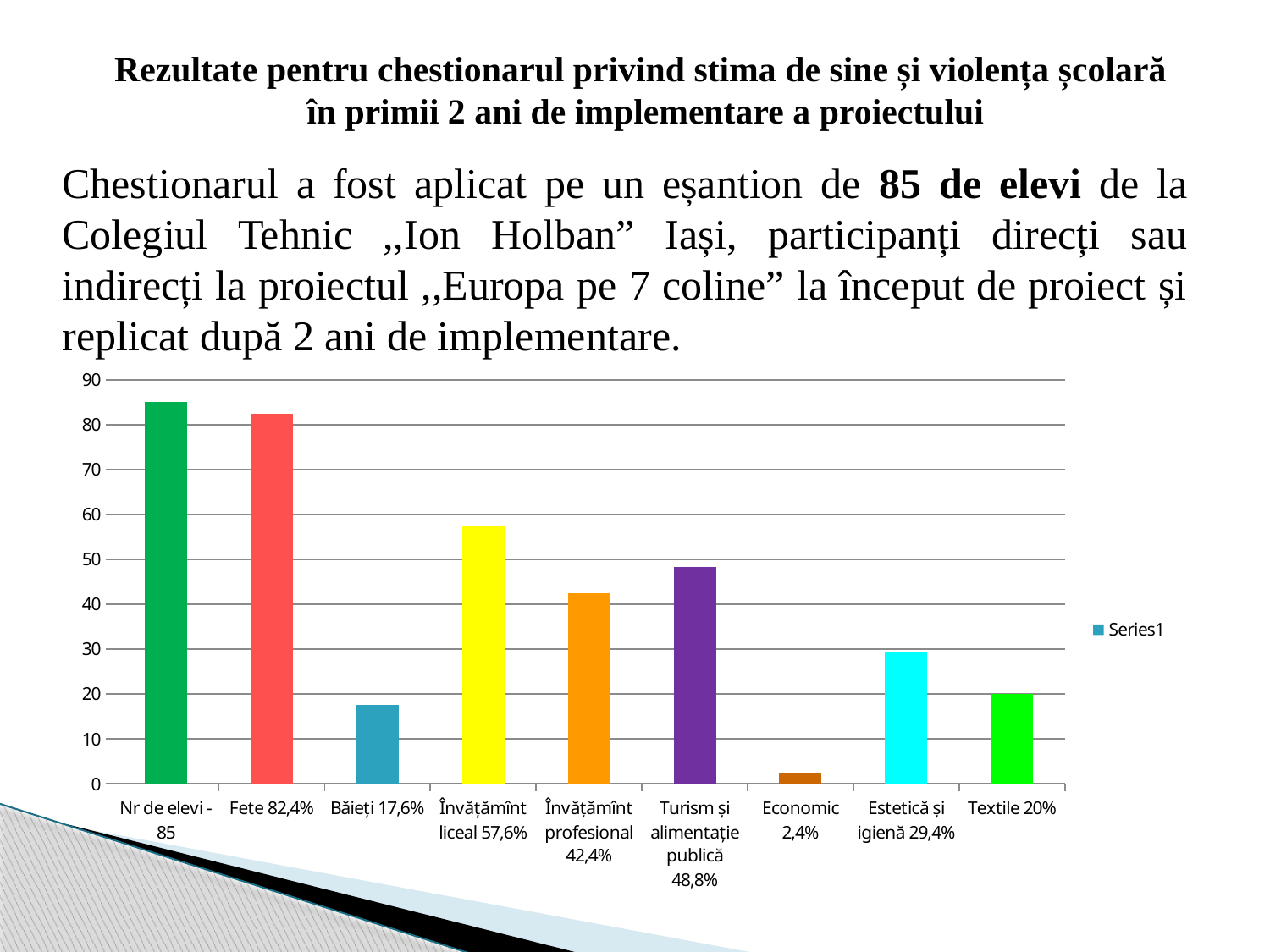
How many series does the chart legend list? 1 Is the value for Estetică și igienă greater or less than 40? less What is the difference in percentage points between Fete (82,4%) and Băieți (17,6%)? 64,8 What percentage is shown for Estetică și igienă in the chart? 29,4% What type of chart is shown on the slide? Bar chart How many categories are shown on the x axis of the chart? 9 What percentage is shown for Fete (girls) in the chart? 82,4% Which category has the lowest bar in the chart? Economic 2,4% What percentage is shown for Învățămînt profesional in the chart? 42,4% Which bar is taller: Turism și alimentație publică or Textile? Turism și alimentație publică Which category has the tallest bar in the chart? Nr de elevi - 85 What is the difference in percentage points between Învățămînt liceal (57,6%) and Învățămînt profesional (42,4%)? 15,2